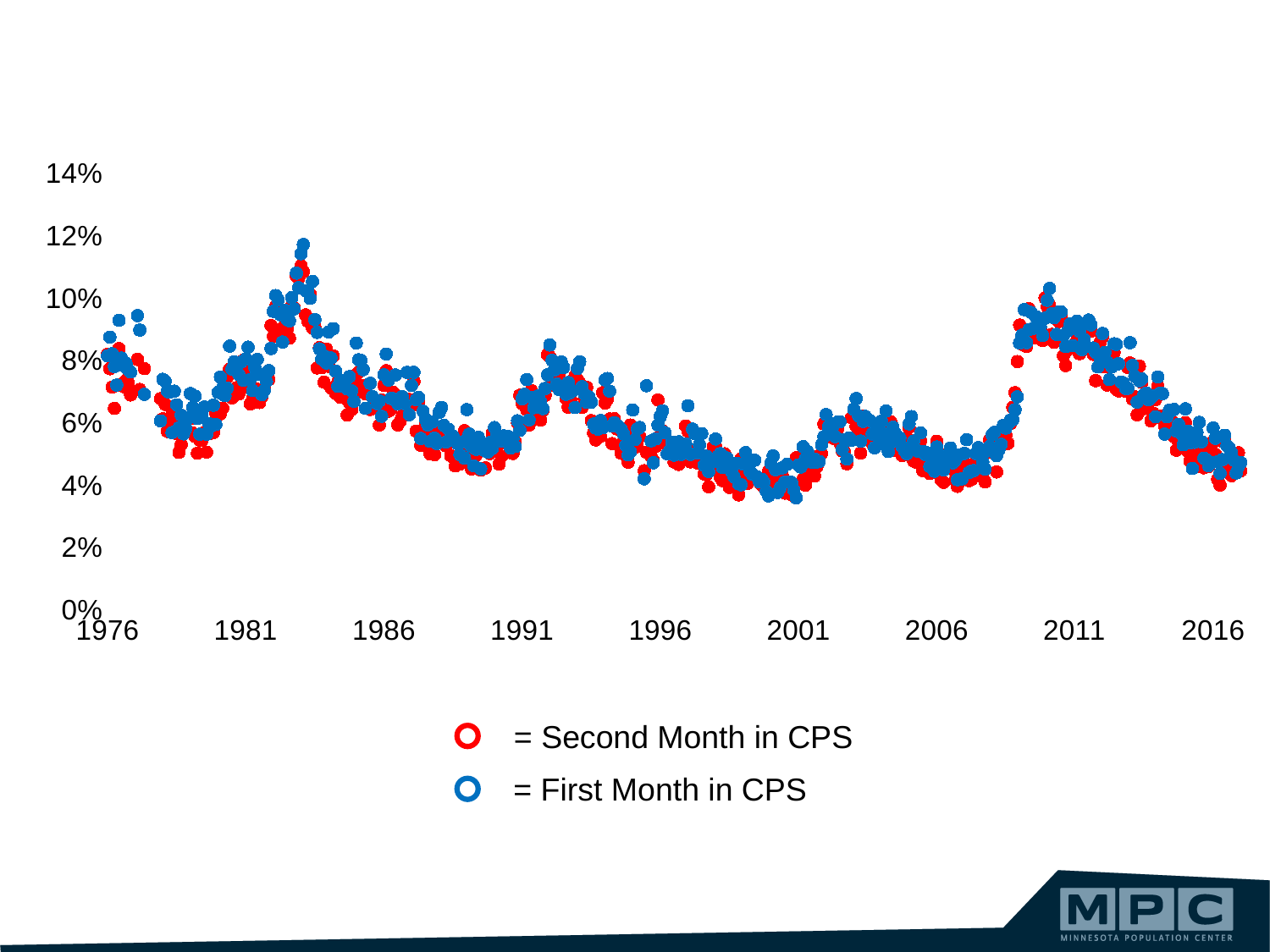
Do the values rise or fall along the x axis from 2006 to 2010? rise How many series does the legend list? 2 Are the values at the right end of the chart, near 2016, greater or less than 6%? less How many year labels are shown on the x axis? 9 Which series is plotted with blue markers? First Month in CPS Are the values around the year 2000 greater or less than 6%? less Which series is plotted with red markers? Second Month in CPS Which is higher: the peak shortly after 1981 or the peak shortly before 2011? The peak shortly after 1981 Do the values rise or fall along the x axis from 2011 to 2016? fall Are the values at the peak just after 1981 (around 1983) greater or less than 10%? greater What kind of chart is shown on the slide? Scatter chart